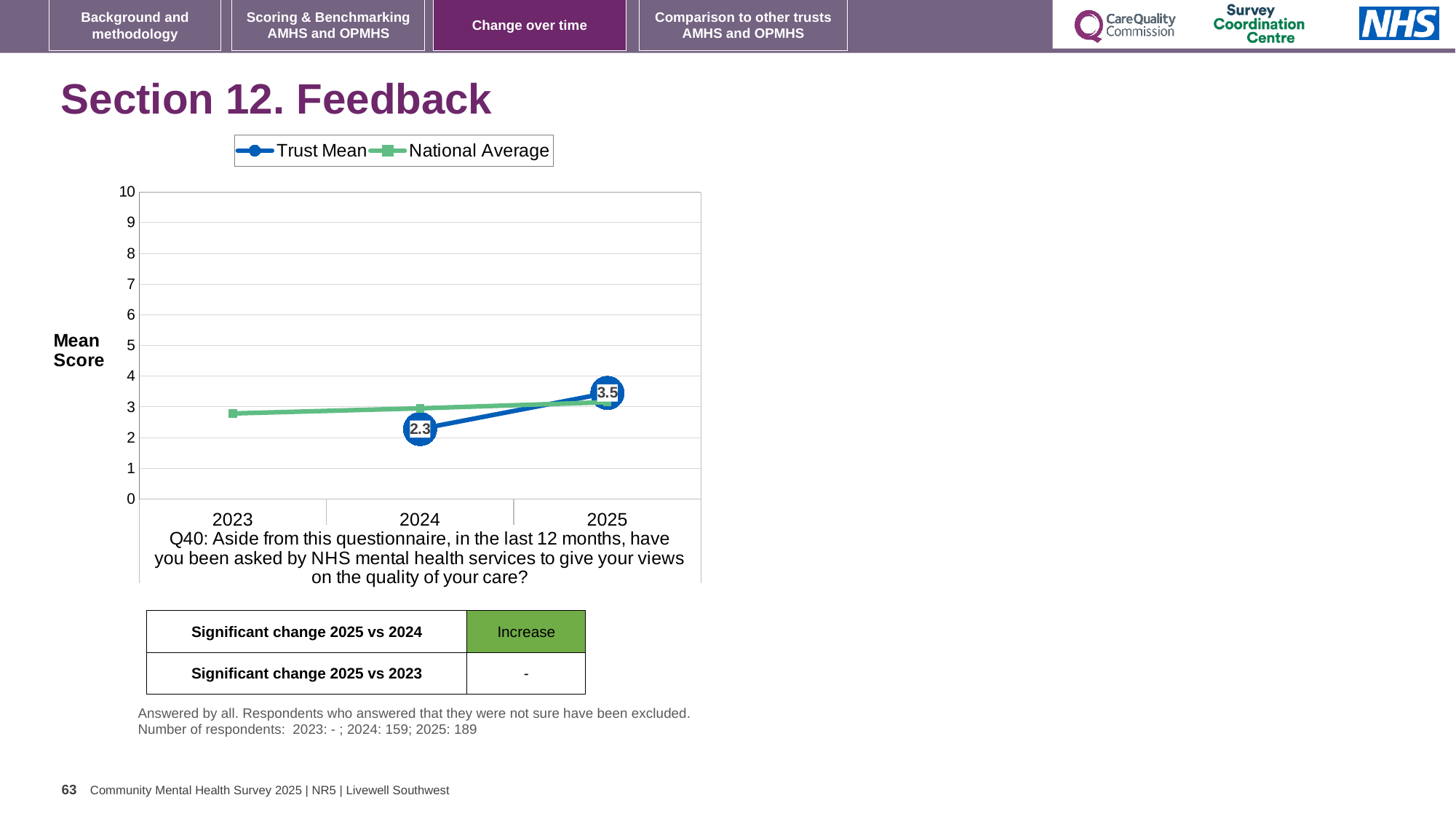
What is the difference between the Trust Mean values for 2025 and 2024? 1.2 Does the Trust Mean rise or fall from 2024 to 2025? rise Is the Trust Mean value for 2025 greater or less than 3? greater What is the Trust Mean value for 2025? 3.5 What are the two series named in the legend? Trust Mean and National Average How many series does the legend list? 2 What kind of chart is shown on the slide? line chart How many years are shown on the x axis? 3 In 2024, which is larger, the Trust Mean or the National Average? National Average Which year has the higher Trust Mean value, 2024 or 2025? 2025 What is the Trust Mean value for 2024? 2.3 Is the National Average value for 2023 greater or less than 5? less